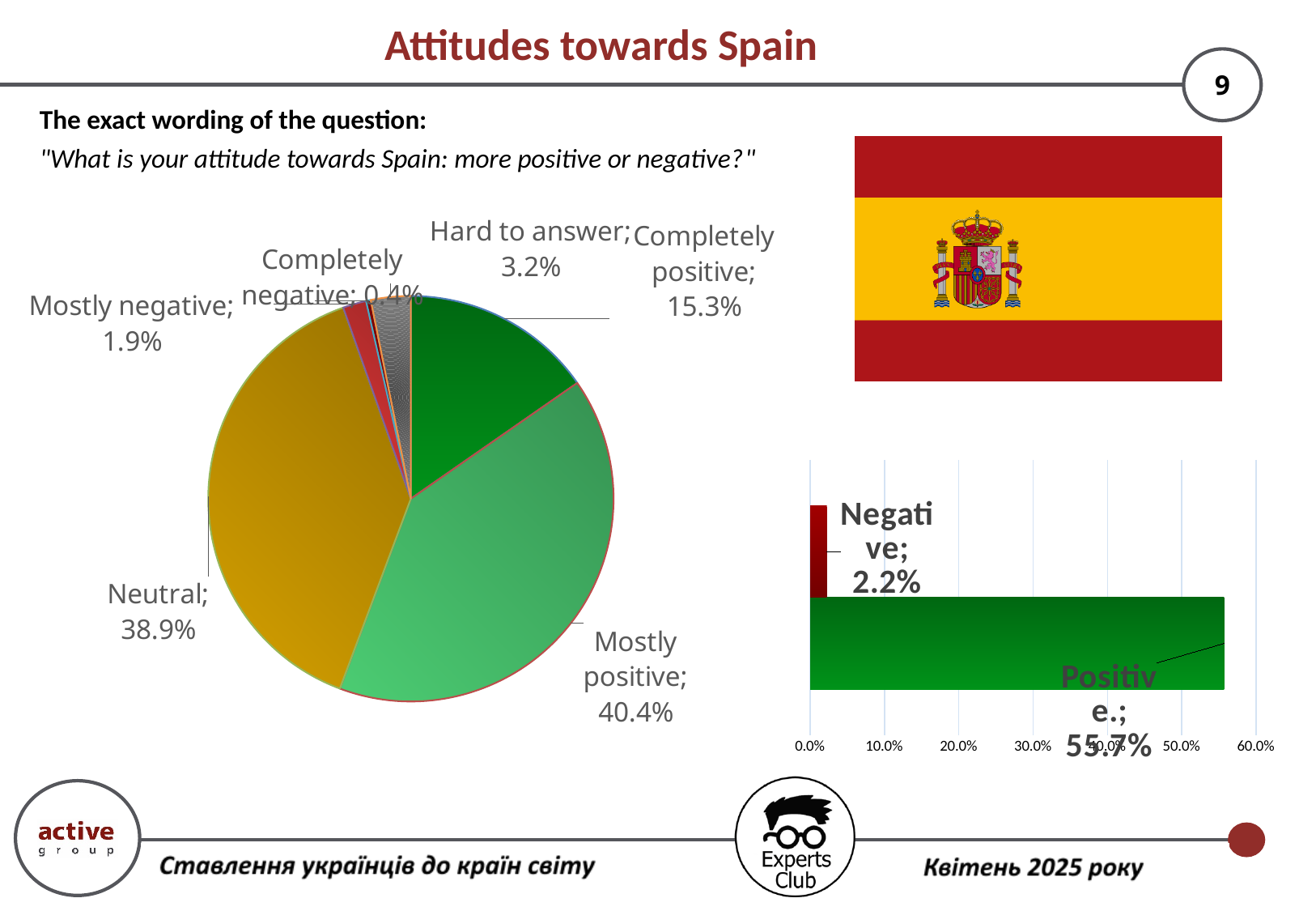
What is the title of the slide containing the charts? Attitudes towards Spain In the pie chart on the left, what share is labelled "Completely positive"? 15.3% In the pie chart on the left, what share is labelled "Hard to answer"? 3.2% In the bar chart on the right, what is the value for "Negative"? 2.2% In the pie chart on the left, what is the difference between the "Mostly positive" and "Neutral" shares? 1.5% In the pie chart on the left, which category has the smallest share? Completely negative In the pie chart on the left, how many slices are there? 6 In the pie chart on the left, which category has the largest share? Mostly positive In the bar chart on the right, what is the value for "Positive"? 55.7% In the pie chart on the left, what share is labelled "Neutral"? 38.9% In the pie chart on the left, what share is labelled "Mostly positive"? 40.4% What kind of chart is shown on the right of the slide? Bar chart